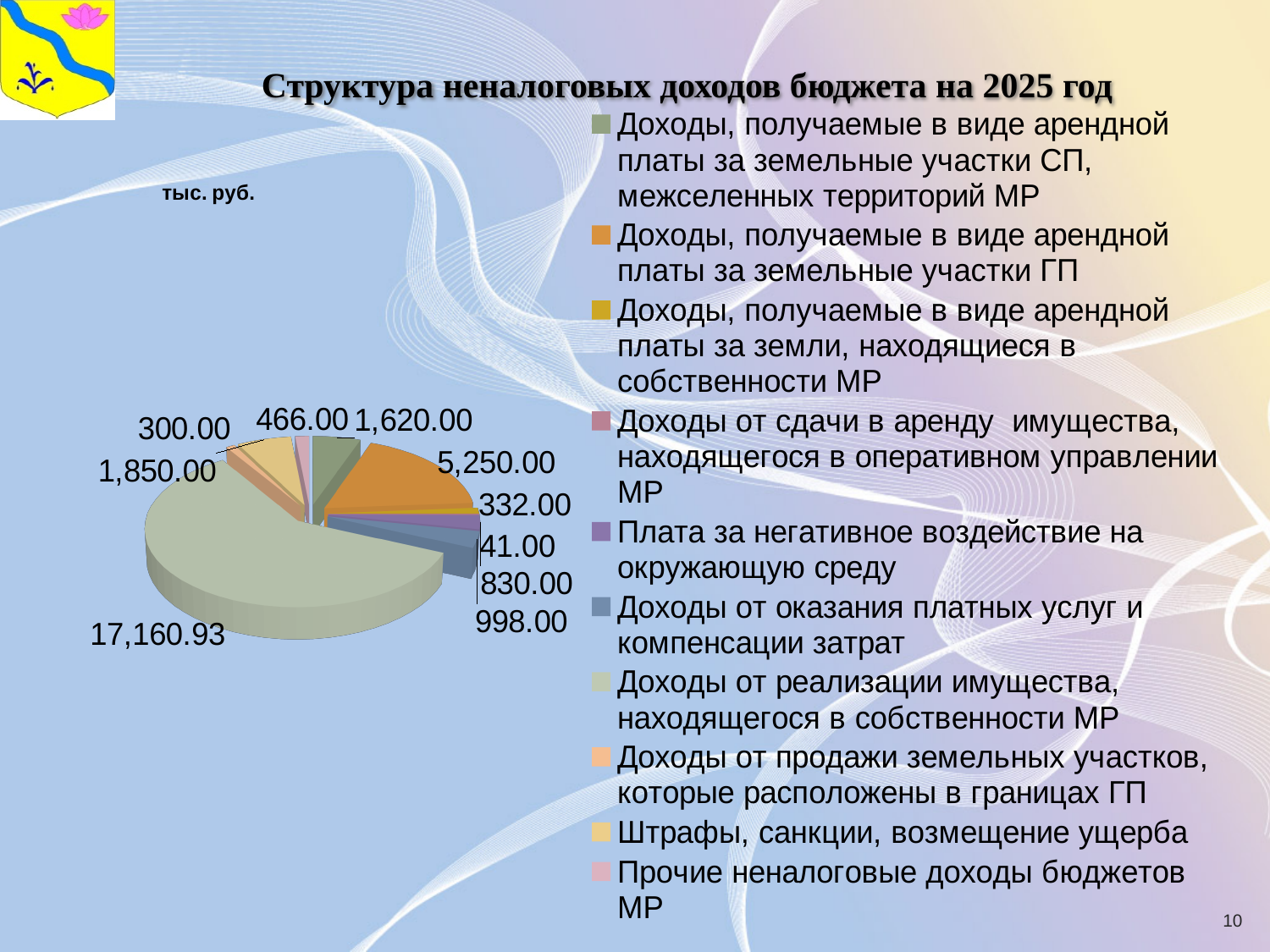
What kind of chart is shown on the slide? pie chart Which category has the largest slice of the pie? Доходы от реализации имущества, находящегося в собственности МР Which category has the smallest slice of the pie? Доходы от сдачи в аренду имущества, находящегося в оперативном управлении МР What is the value for 'Доходы, получаемые в виде арендной платы за земельные участки ГП'? 5,250.00 What is the value for 'Доходы от реализации имущества, находящегося в собственности МР'? 17,160.93 What is the value for 'Доходы от оказания платных услуг и компенсации затрат'? 998.00 In what units are the values on the chart given? тыс. руб. What is the difference between the value for 'Доходы, получаемые в виде арендной платы за земельные участки ГП' and the value for 'Доходы, получаемые в виде арендной платы за земельные участки СП, межселенных территорий МР'? 3,630.00 What is the value for 'Штрафы, санкции, возмещение ущерба'? 1,850.00 Which is larger: the value for 'Доходы от продажи земельных участков, которые расположены в границах ГП' or the value for 'Прочие неналоговые доходы бюджетов МР'? Прочие неналоговые доходы бюджетов МР How many entries does the legend list? 10 How many slices does the pie chart have? 10